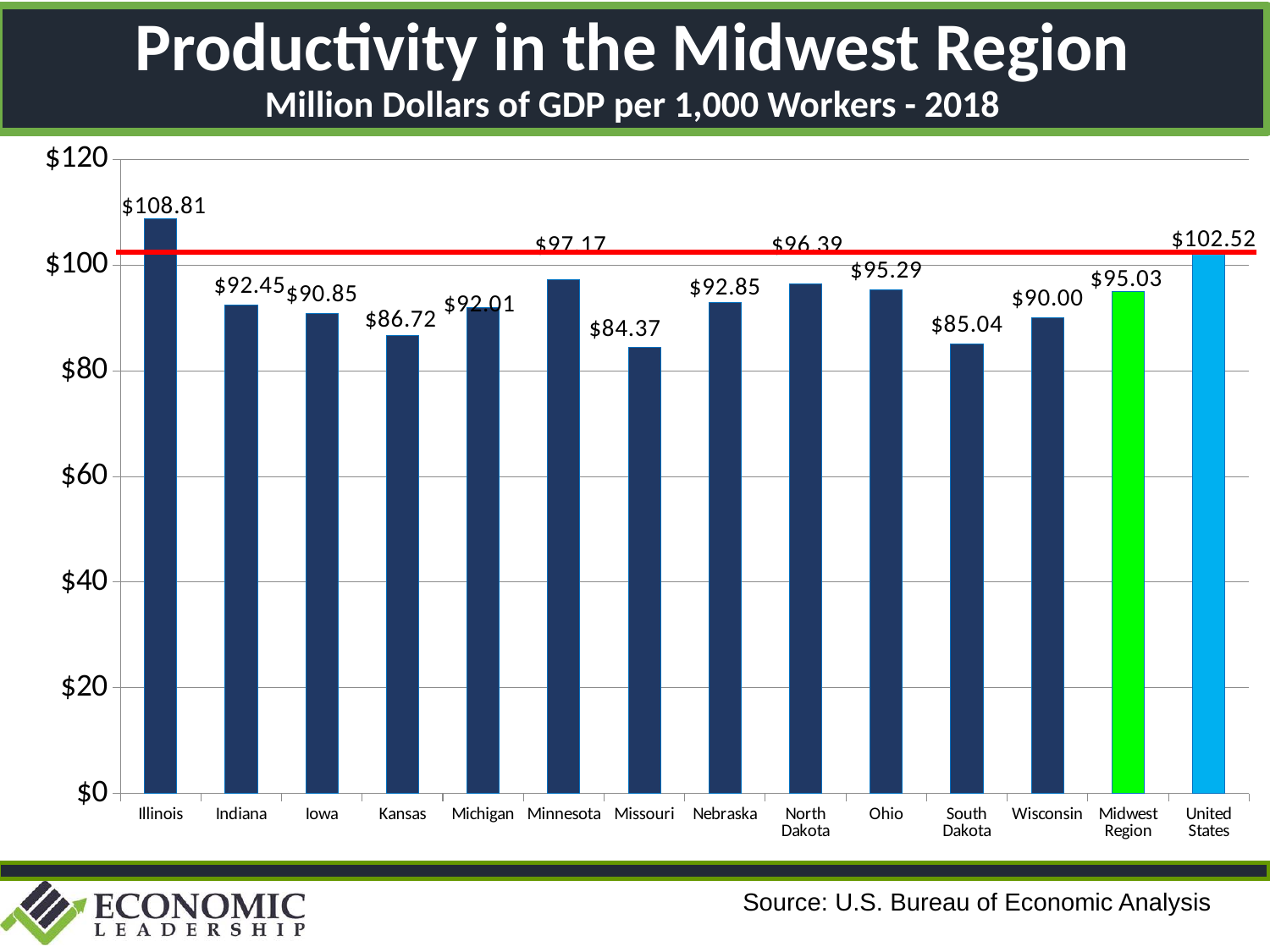
What is the value for Illinois? $108.81 Which category has the lowest value? Missouri What is the value for Missouri? $84.37 What kind of chart is shown on the slide? bar chart Which has a larger value, Minnesota or North Dakota? Minnesota Which category has the highest value? Illinois What is the difference between the values for Illinois and the United States? $6.29 What is the difference between the values for the United States and the Midwest Region? $7.49 What is the value for the Midwest Region? $95.03 Is the value for Ohio greater or less than $100? less How many categories are shown on the x axis? 14 What is the value for Wisconsin? $90.00